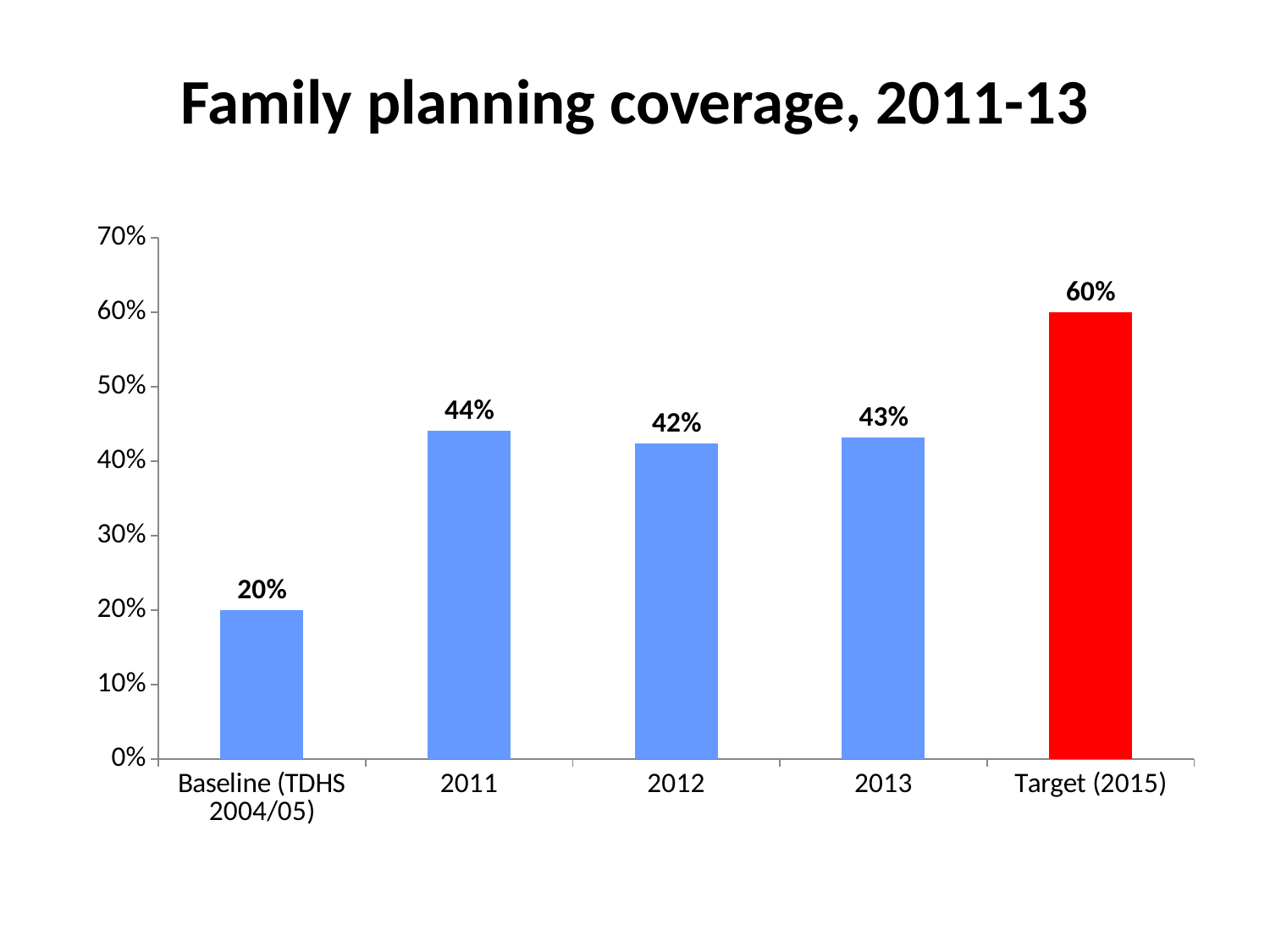
Which is larger, the value for 2011 or the value for 2012? 2011 How many bars are shown in the chart? 5 What is the family planning coverage value for 2011? 44% Is the value for 2013 greater or less than 50%? less What is the difference between the 2011 value and the Baseline (TDHS 2004/05) value? 24% Which category has the highest value? Target (2015) What is the title of the chart? Family planning coverage, 2011-13 Which category has the lowest value? Baseline (TDHS 2004/05) What is the difference between the Target (2015) value and the 2013 value? 17% What is the value shown for Target (2015)? 60% What kind of chart is shown on the slide? bar chart What is the value shown for the Baseline (TDHS 2004/05) bar? 20%